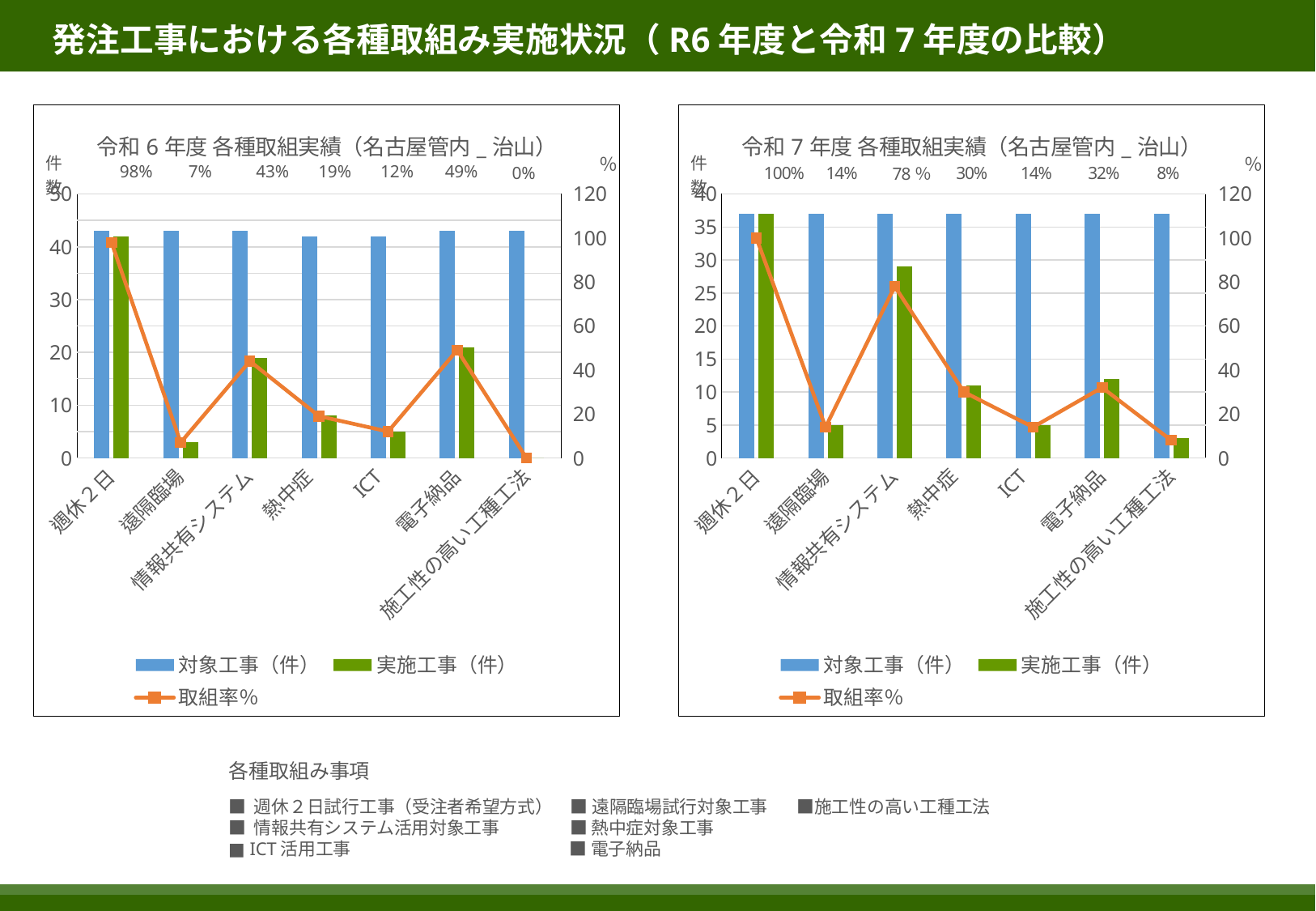
In the 令和6年度 chart (left), which category has the lowest 取組率%? 施工性の高い工種工法 In the 令和6年度 chart (left), what is the 取組率% for 週休2日? 98% In the 令和7年度 chart (right), what is the 取組率% for 情報共有システム? 78% In the 令和7年度 chart (right), which category has the highest 取組率%? 週休2日 In the 令和6年度 chart (left), is the 実施工事（件） value for 遠隔臨場 greater or less than 10? less How many categories are shown on the x axis of the 令和7年度 chart (right)? 7 What is the title of the chart on the right? 令和7年度 各種取組実績（名古屋管内_治山） How many series does the legend of the 令和6年度 chart (left) list? 3 In the 令和6年度 chart (left), which has a higher 取組率%, 情報共有システム or 電子納品? 電子納品 In the 令和7年度 chart (right), is the 実施工事（件） value for 情報共有システム greater or less than 20? greater In the 令和6年度 chart (left), what is the difference in 取組率% between 週休2日 and 電子納品? 49 percentage points In the 令和7年度 chart (right), what is the difference in 取組率% between 情報共有システム and 熱中症? 48 percentage points